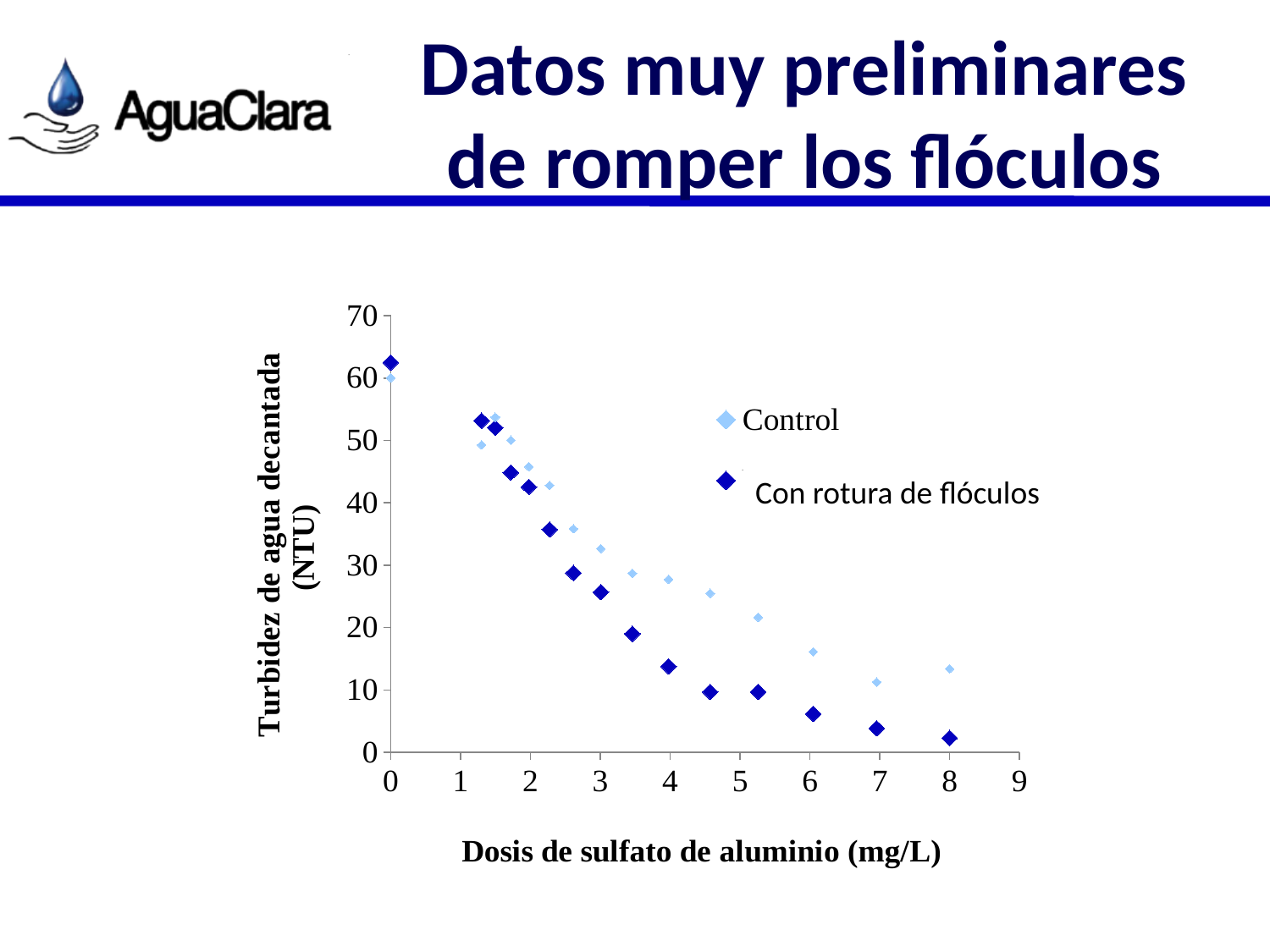
Is the turbidity for Con rotura de flóculos at a dose of 0 mg/L greater or less than 60 NTU? greater Is the turbidity for Con rotura de flóculos at a dose of 8 mg/L greater or less than 10 NTU? less What is the title of the x axis? Dosis de sulfato de aluminio (mg/L) Is the turbidity for Control at a dose of 8 mg/L greater or less than 10 NTU? greater How many series does the legend list? 2 Do the turbidity values for the Con rotura de flóculos series rise or fall as the aluminium sulfate dose increases? fall At which dose does the Con rotura de flóculos series reach its lowest turbidity? 8 What are the two series named in the legend? Control; Con rotura de flóculos What kind of chart is shown on the slide? scatter chart Do the turbidity values for the Control series rise or fall as the dose increases from 0 to 8 mg/L? fall At a dose of 6 mg/L, which series has the higher turbidity, Control or Con rotura de flóculos? Control